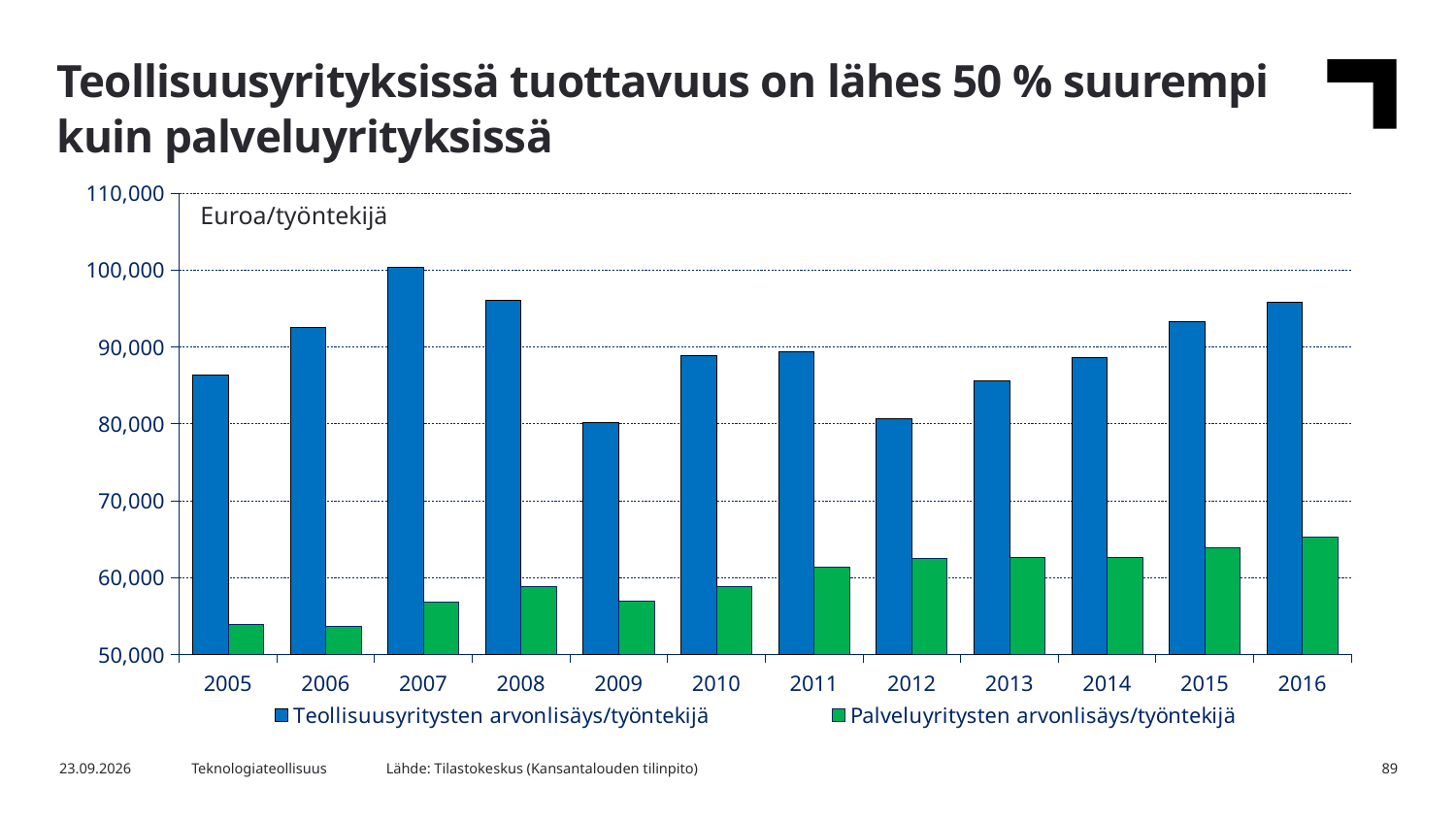
How many series does the legend list? 2 In which year is the value for Palveluyritysten arvonlisäys/työntekijä highest? 2016 Is the value for Palveluyritysten arvonlisäys/työntekijä in 2005 greater or less than 60,000? less How many years are shown on the x axis? 12 What unit label is shown inside the chart area? Euroa/työntekijä Which is larger, the value for Teollisuusyritysten arvonlisäys/työntekijä in 2006 or in 2005? 2006 Does the value for Palveluyritysten arvonlisäys/työntekijä generally rise or fall from 2005 to 2016? rise In which year is the value for Teollisuusyritysten arvonlisäys/työntekijä highest? 2007 What kind of chart is shown on the slide? bar chart Is the value for Palveluyritysten arvonlisäys/työntekijä in 2016 greater or less than 60,000? greater Is the value for Teollisuusyritysten arvonlisäys/työntekijä in 2009 greater or less than 90,000? less